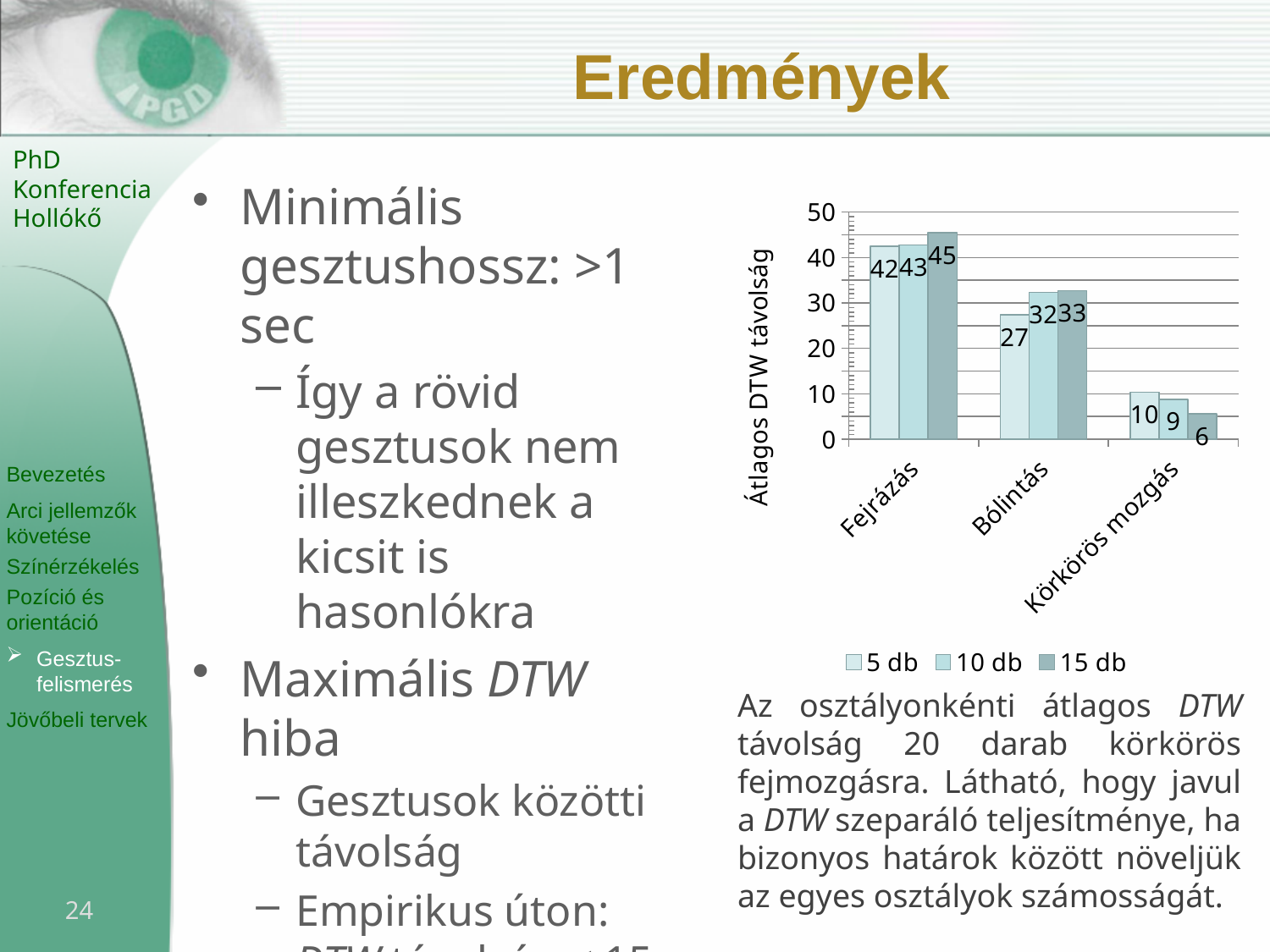
What is the value for Fejrázás in the 5 db series? 42 What is the label of the y axis? Átlagos DTW távolság Is the value for Bólintás in the 5 db series greater or less than 30? less What is the value for Körkörös mozgás in the 10 db series? 9 Which category has the lowest value in the 5 db series? Körkörös mozgás How many series does the legend list? 3 Which is larger for Bólintás: the 5 db value or the 10 db value? 10 db How many categories are shown on the x axis? 3 What is the value for Bólintás in the 15 db series? 33 Which category has the highest value in the 15 db series? Fejrázás What kind of chart is shown on the slide? bar chart What is the difference between the 15 db and 5 db values for Fejrázás? 3